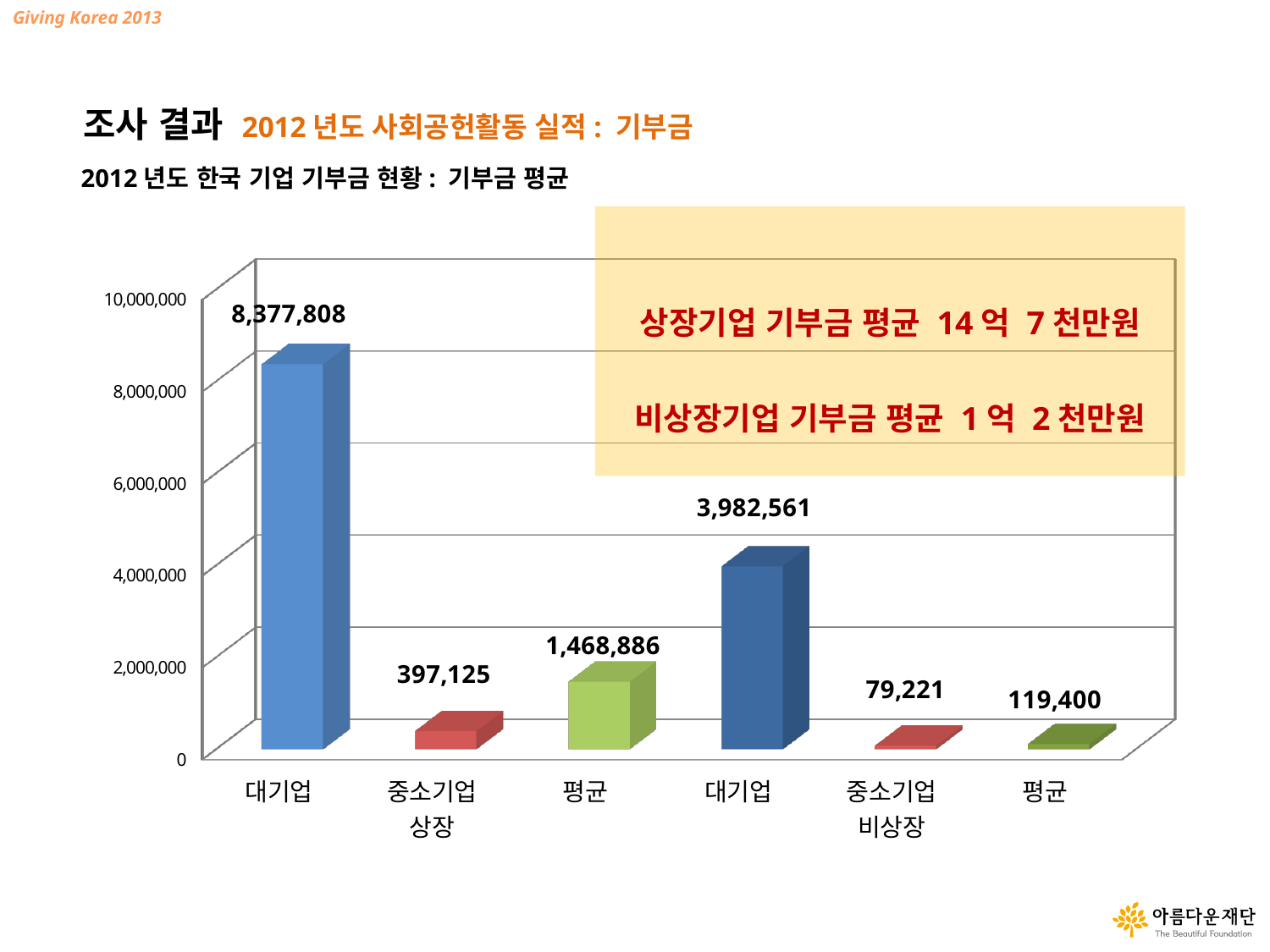
What is the value shown for 대기업 in the 비상장 group? 3,982,561 Which is larger: the 중소기업 value in the 상장 group or the 중소기업 value in the 비상장 group? 중소기업 (상장) Is the value for 대기업 in the 상장 group greater or less than 8,000,000? greater Which bar has the lowest value in the chart? 중소기업 (비상장) What is the difference between the 대기업 value in the 상장 group and the 대기업 value in the 비상장 group? 4,395,247 Which bar has the highest value in the chart? 대기업 (상장) What kind of chart is shown on the slide? bar chart What is the value shown for 평균 in the 상장 group? 1,468,886 What is the difference between the 평균 value in the 상장 group and the 평균 value in the 비상장 group? 1,349,486 How many bars are plotted in the chart? 6 What is the value shown for 대기업 in the 상장 group? 8,377,808 What is the value shown for 중소기업 in the 비상장 group? 79,221